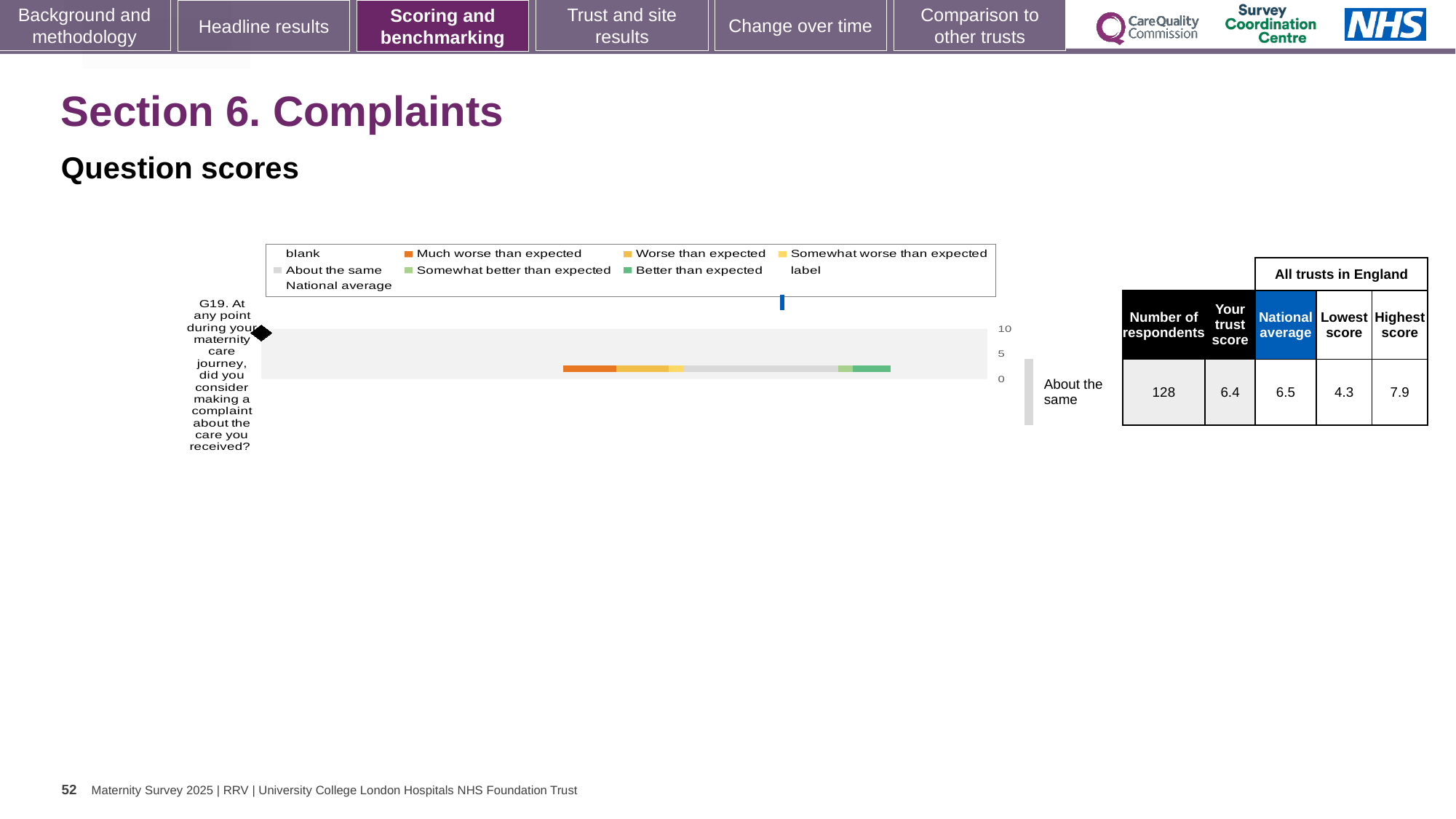
According to the table beside the chart, what is the trust's score for G19? 6.4 According to the table beside the chart, what is the national average score for G19? 6.5 According to the table beside the chart, what is the lowest score among all trusts in England for G19? 4.3 What kind of chart is shown on the slide? bar chart According to the table beside the chart, what is the highest score among all trusts in England for G19? 7.9 What is the difference between the highest and lowest trust scores for G19 shown in the table? 3.6 According to the table beside the chart, how many respondents answered G19? 128 By how much does the national average exceed the trust's score for G19? 0.1 How many survey questions are plotted in the chart? 1 What benchmark category is the trust's G19 result labelled as on the slide? About the same Which is larger for G19: the trust's score or the national average? National average Which survey question is plotted in the chart? G19. At any point during your maternity care journey, did you consider making a complaint about the care you received?